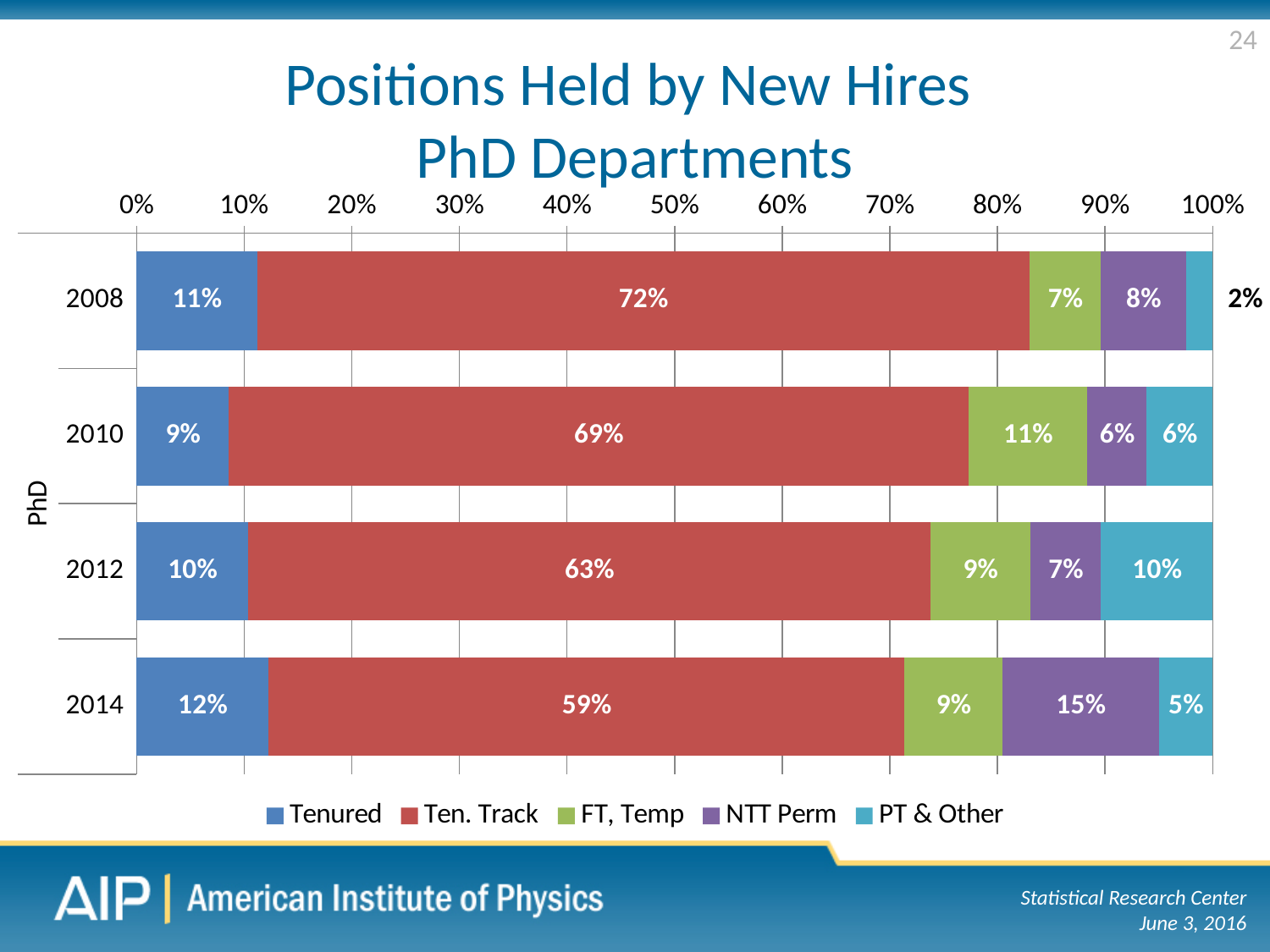
What is the NTT Perm value for 2014? 15% What is the FT, Temp value for 2010? 11% Which is larger, the Tenured value for 2014 or the Tenured value for 2010? 2014 Which year has the highest Ten. Track percentage? 2008 What kind of chart is shown on the slide? Stacked bar chart What percentage of new hires in 2008 held Ten. Track positions? 72% Which year has the lowest PT & Other percentage? 2008 What is the difference between the Ten. Track values for 2008 and 2014? 13% How many series does the legend list? 5 What is the PT & Other value for 2012? 10% How many years are shown on the chart? 4 Does the Ten. Track percentage rise or fall from 2008 to 2014? Fall